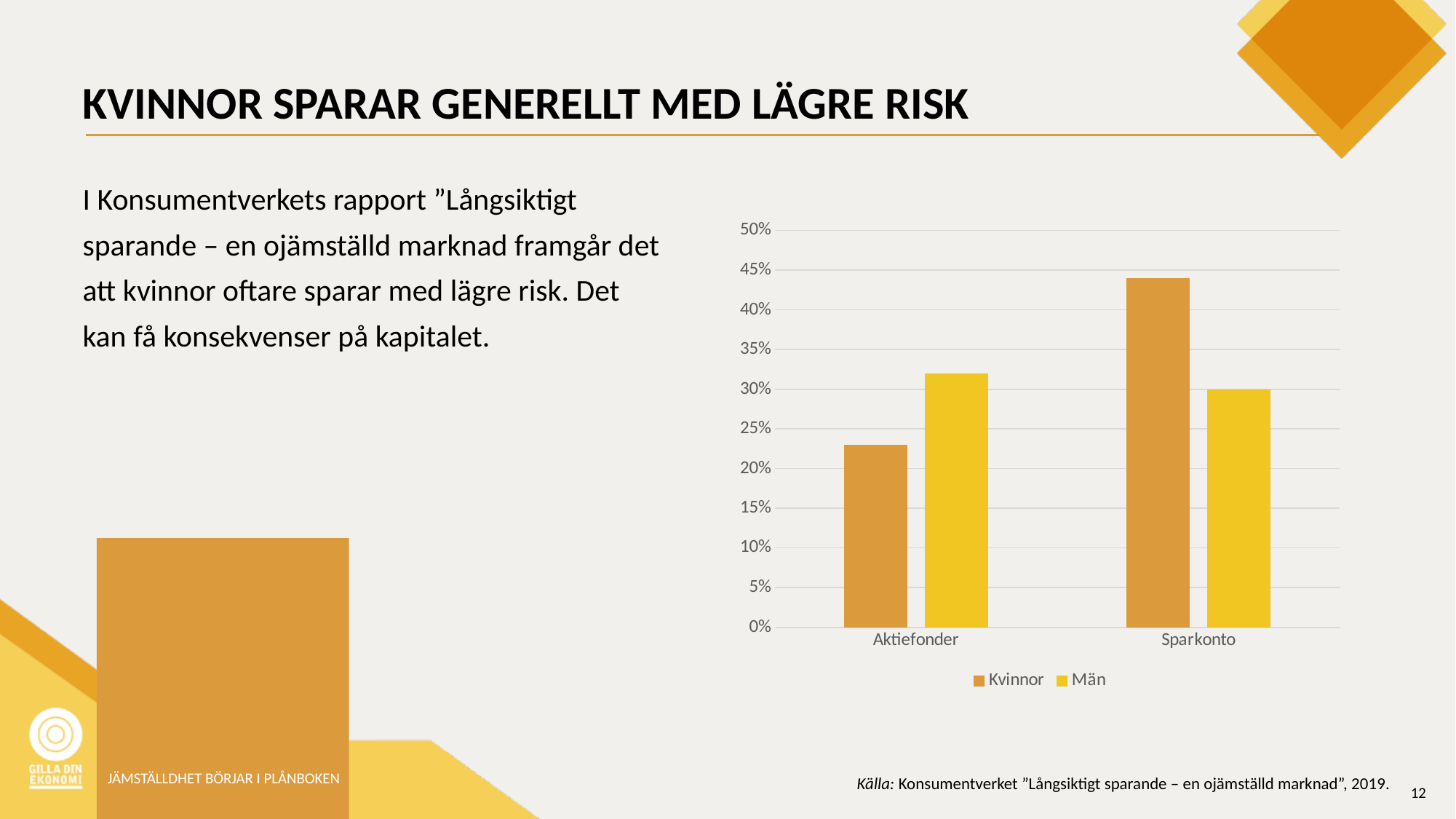
Which bar in the chart is the shortest? Kvinnor, Aktiefonder Is the value for Kvinnor in Aktiefonder greater or less than 25%? less Which bar in the chart is the tallest? Kvinnor, Sparkonto Which series has the higher value for Sparkonto, Kvinnor or Män? Kvinnor How many categories are shown on the x axis of the chart? 2 Is the value for Män in Aktiefonder greater or less than 30%? greater What are the two legend entries of the chart? Kvinnor and Män Which series has the higher value for Aktiefonder, Kvinnor or Män? Män How many series does the chart legend list? 2 What kind of chart is shown on the slide? bar chart Is the value for Kvinnor in Sparkonto greater or less than 40%? greater What is the highest value shown on the chart's vertical axis? 50%